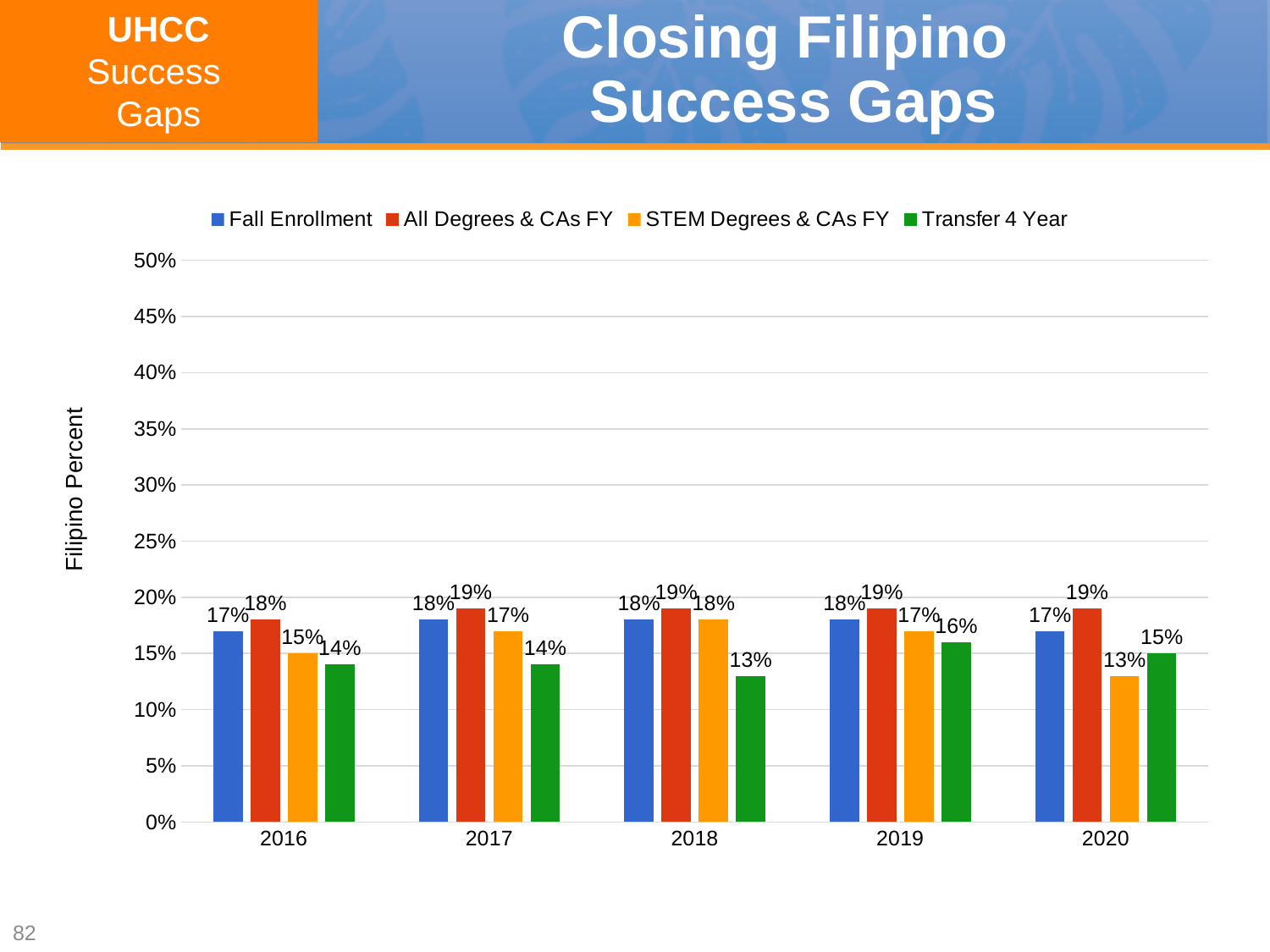
What is the difference between the All Degrees & CAs FY value and the Transfer 4 Year value in 2018? 6% What is the Fall Enrollment value for 2016? 17% What is the STEM Degrees & CAs FY value for 2020? 13% Which is larger in 2020: the Transfer 4 Year value or the STEM Degrees & CAs FY value? Transfer 4 Year What is the label on the vertical axis? Filipino Percent In which year is the STEM Degrees & CAs FY value lowest? 2020 How many series does the legend list? 4 What is the Transfer 4 Year value for 2018? 13% What is the All Degrees & CAs FY value for 2019? 19% In which year is the Transfer 4 Year value highest? 2019 What kind of chart is shown on the slide? Bar chart How many years are shown on the x axis? 5